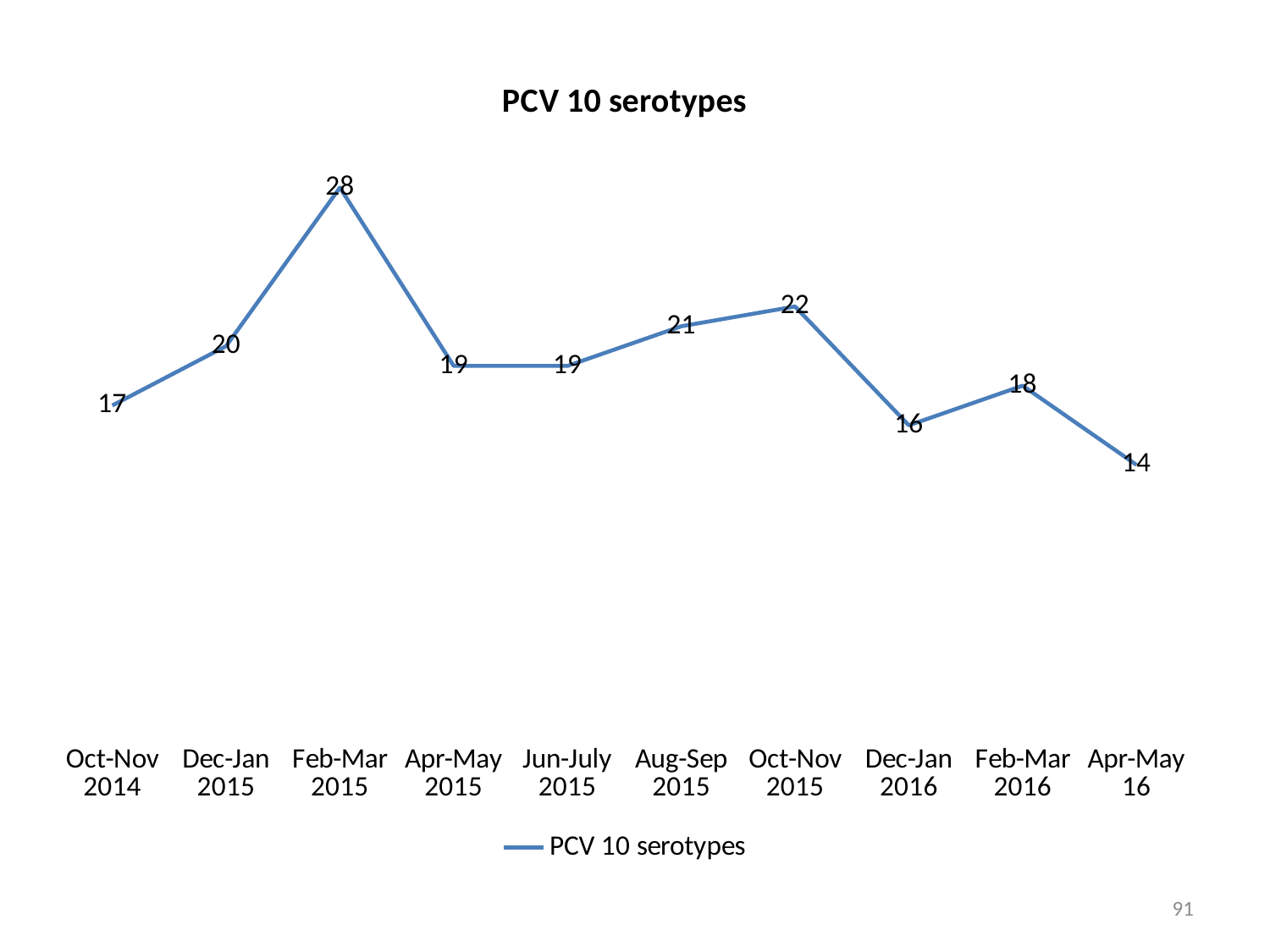
Do the values rise or fall from Oct-Nov 2015 to Apr-May 16? fall What is the value for Oct-Nov 2015? 22 Which period has the lowest value? Apr-May 16 How many periods are plotted on the x axis? 10 Which is larger, the value for Dec-Jan 2015 or the value for Dec-Jan 2016? Dec-Jan 2015 What is the value for Apr-May 16? 14 How many series does the legend list? 1 Which period has the highest value? Feb-Mar 2015 What is the difference between the values for Feb-Mar 2015 and Apr-May 2015? 9 What is the title of the chart? PCV 10 serotypes What kind of chart is this? line chart What is the value for Feb-Mar 2015? 28